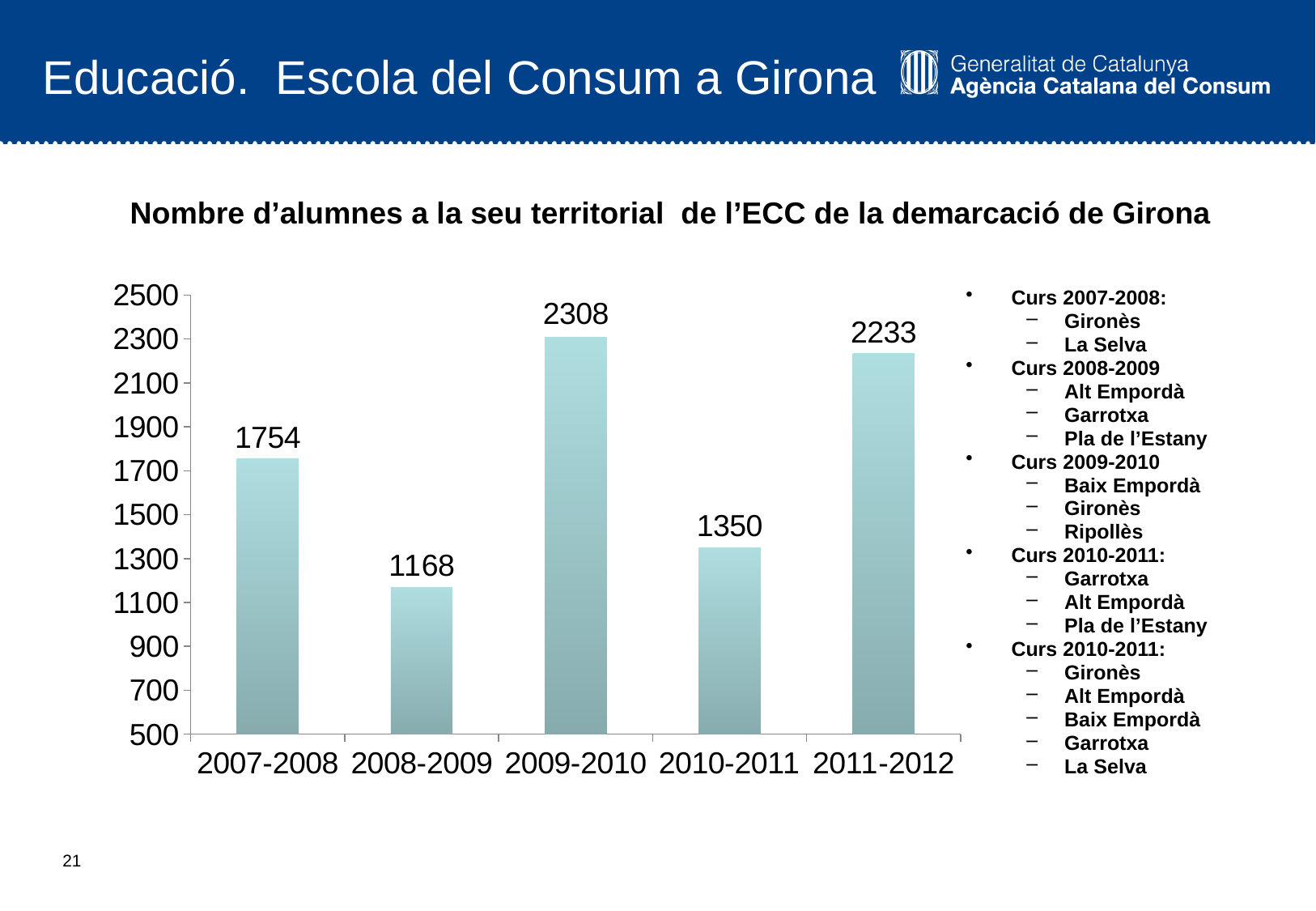
What is the number of students for 2007-2008? 1754 What is the title of the chart? Nombre d'alumnes a la seu territorial de l'ECC de la demarcació de Girona Which is larger, the value for 2007-2008 or the value for 2010-2011? 2007-2008 Is the value for 2008-2009 greater or less than 1300? less Which academic year has the lowest number of students? 2008-2009 What kind of chart is shown on the slide? bar chart What is the number of students for 2011-2012? 2233 Which academic year has the highest number of students? 2009-2010 What is the difference between the values for 2011-2012 and 2010-2011? 883 How many academic years are shown on the x axis? 5 What is the difference between the values for 2009-2010 and 2008-2009? 1140 What is the number of students for 2009-2010? 2308